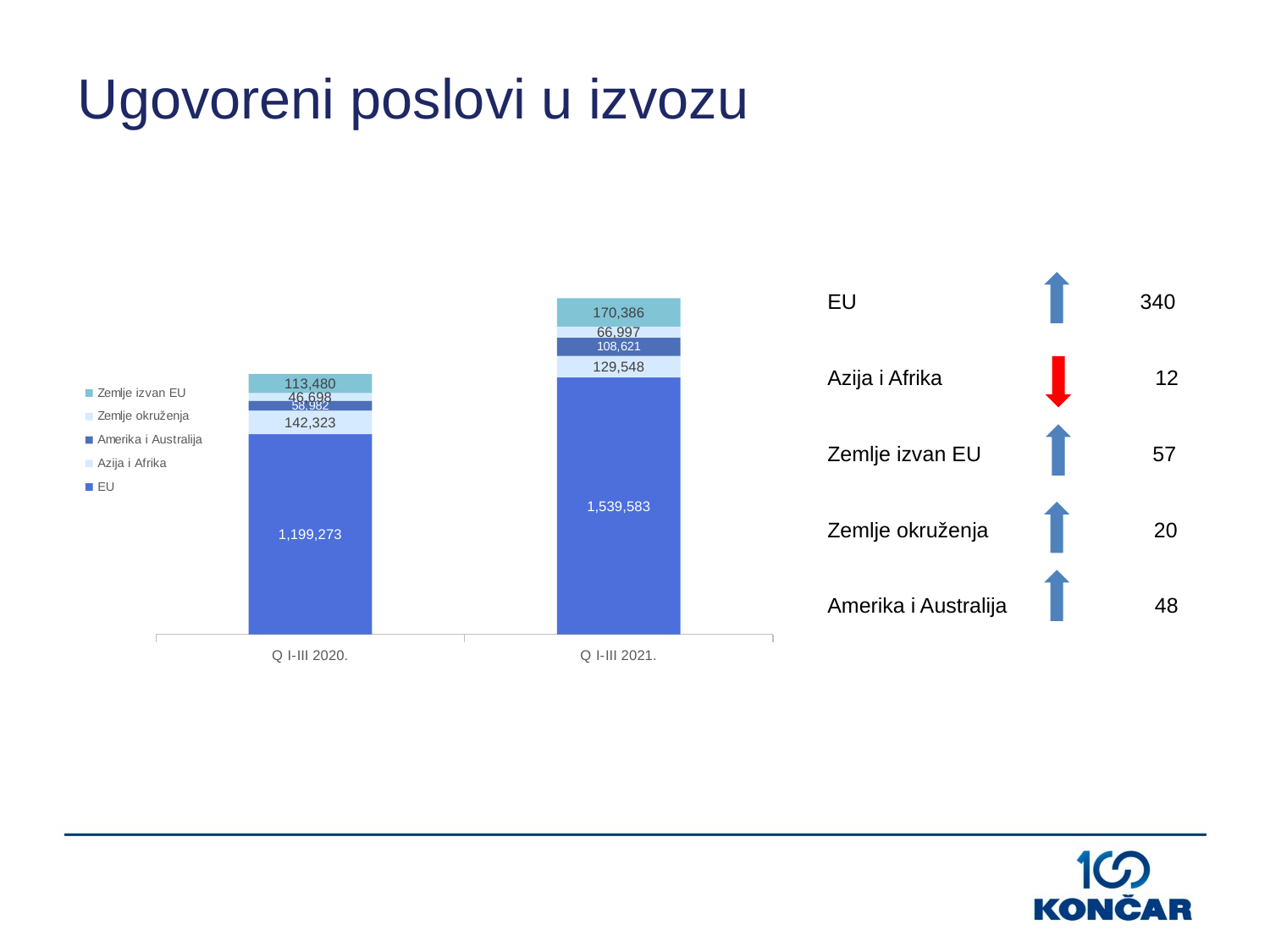
What is the total of the stacked bar for Q I-III 2021.? 2,015,135 Which series is the largest segment in the Q I-III 2021. bar? EU What is the EU value for Q I-III 2021.? 1,539,583 What is the value for Zemlje izvan EU in Q I-III 2021.? 170,386 What is the EU value for Q I-III 2020.? 1,199,273 By how much did the EU value increase from Q I-III 2020. to Q I-III 2021.? 340,310 What is the value for Amerika i Australija in Q I-III 2021.? 108,621 How many series does the chart legend list? 5 What type of chart is shown on the slide? Stacked bar chart How many periods (categories) are shown on the x axis of the chart? 2 What is the value for Azija i Afrika in Q I-III 2020.? 142,323 Which is larger: the Azija i Afrika value in Q I-III 2020. or in Q I-III 2021.? Q I-III 2020.